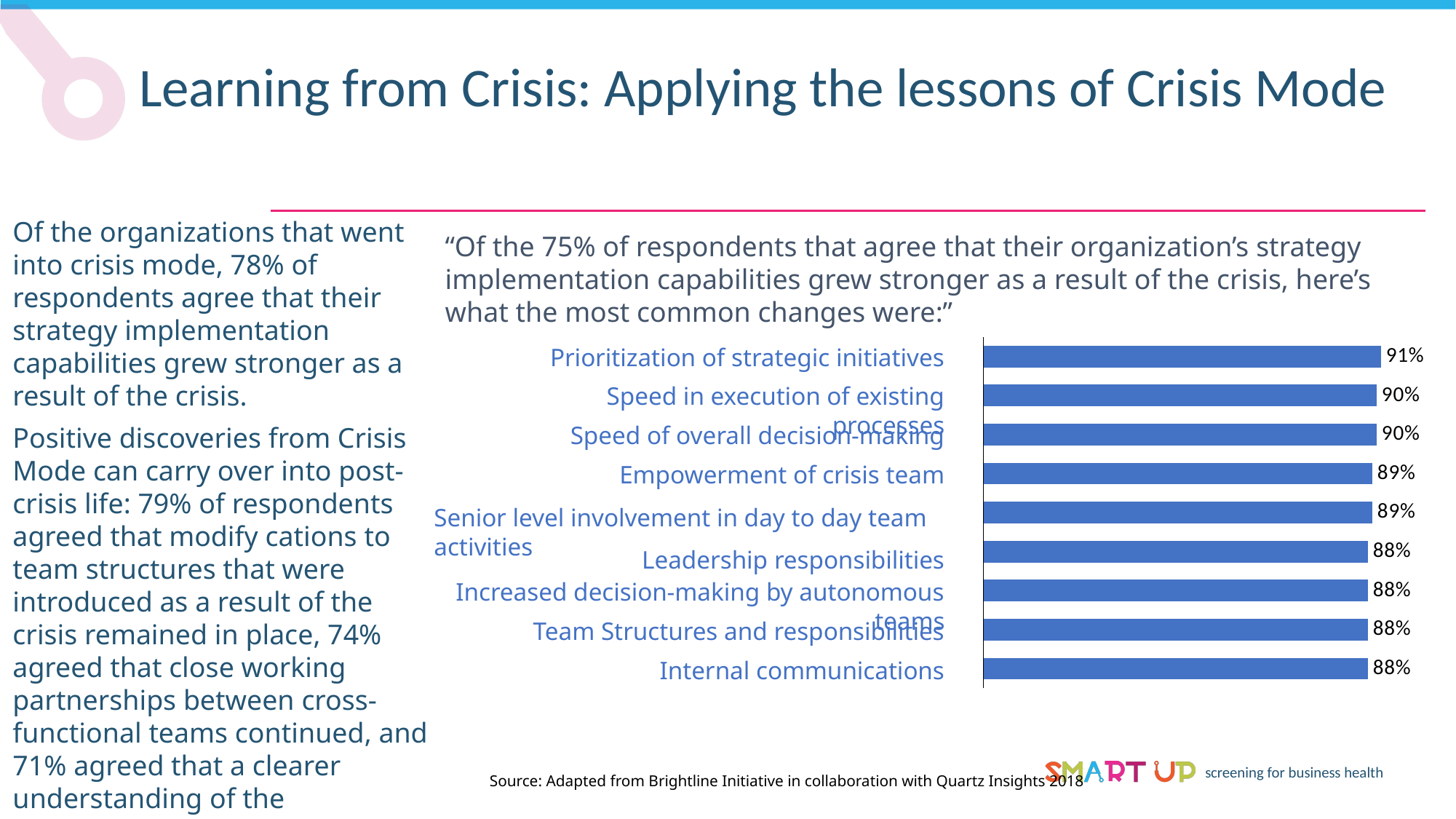
What is the value for Speed of overall decision-making? 90% Which category has the highest value in the chart? Prioritization of strategic initiatives Do the bar values rise or fall going from the top category to the bottom category? fall What is the difference between the values for Prioritization of strategic initiatives and Internal communications? 3 percentage points How many categories are plotted in the bar chart? 9 What colour are the bars in the chart? blue What is the value for Prioritization of strategic initiatives? 91% What is the value for Internal communications? 88% Which is larger: the value for Speed of overall decision-making or the value for Team Structures and responsibilities? Speed of overall decision-making What is the value for Empowerment of crisis team? 89% What type of chart is shown on the slide? bar chart What is the value for Leadership responsibilities? 88%